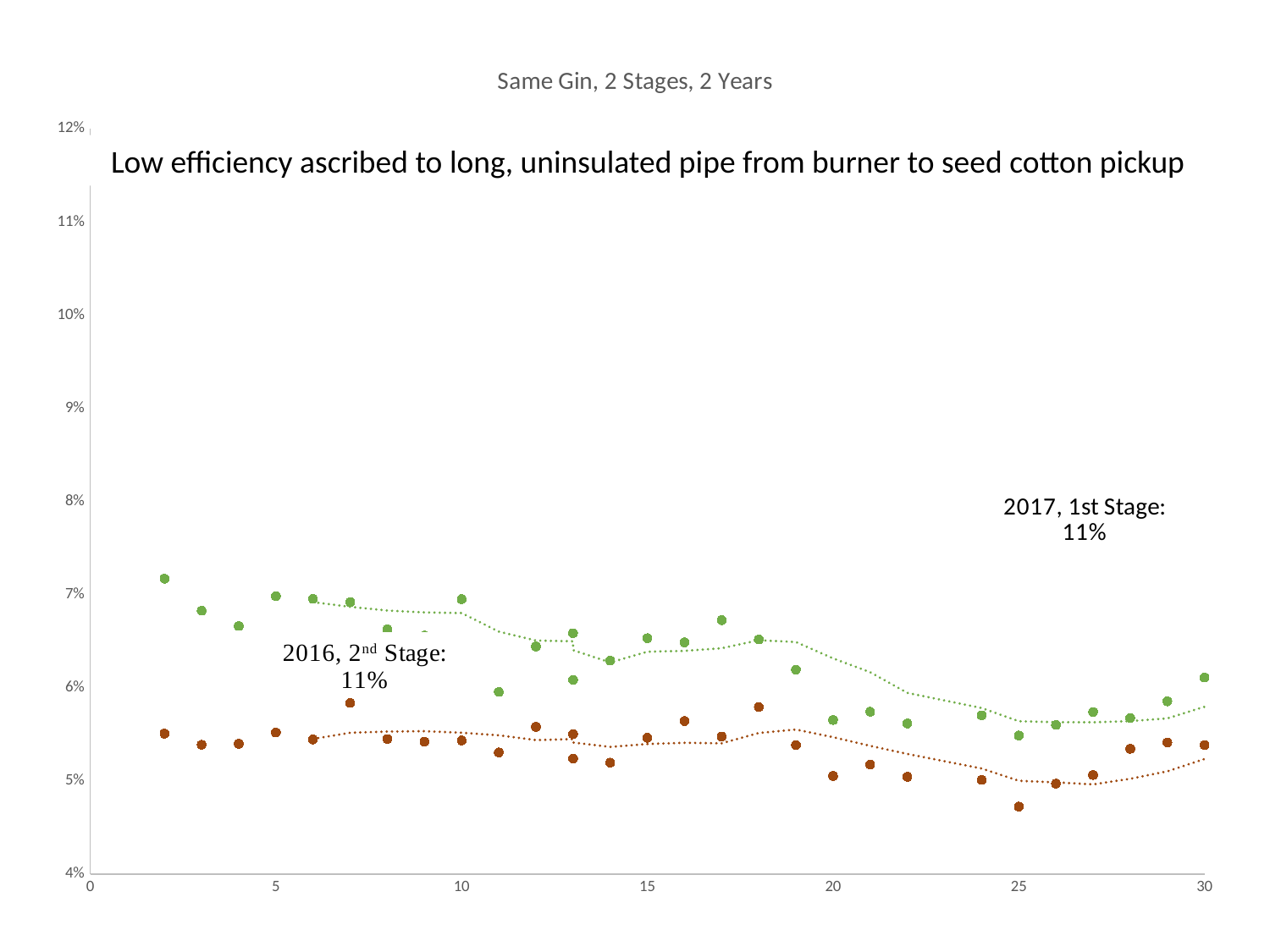
At x = 2, which series has the larger value, 2017, 1st Stage or 2016, 2nd Stage? 2017, 1st Stage Is the value of the 2016, 2nd Stage series at x = 25 greater or less than 5%? less What is the lowest value shown on the vertical axis? 4% Which series has the higher values across the chart, 2017, 1st Stage or 2016, 2nd Stage? 2017, 1st Stage Is the value of the 2016, 2nd Stage series at x = 7 greater or less than 6%? less Is the value of the 2017, 1st Stage series at x = 25 greater or less than 6%? less What kind of chart is shown on the slide? scatter chart Do the values of the 2017, 1st Stage series generally rise or fall from x = 2 to x = 26? fall Which series is plotted with green points? 2017, 1st Stage What is the title of the chart? Same Gin, 2 Stages, 2 Years